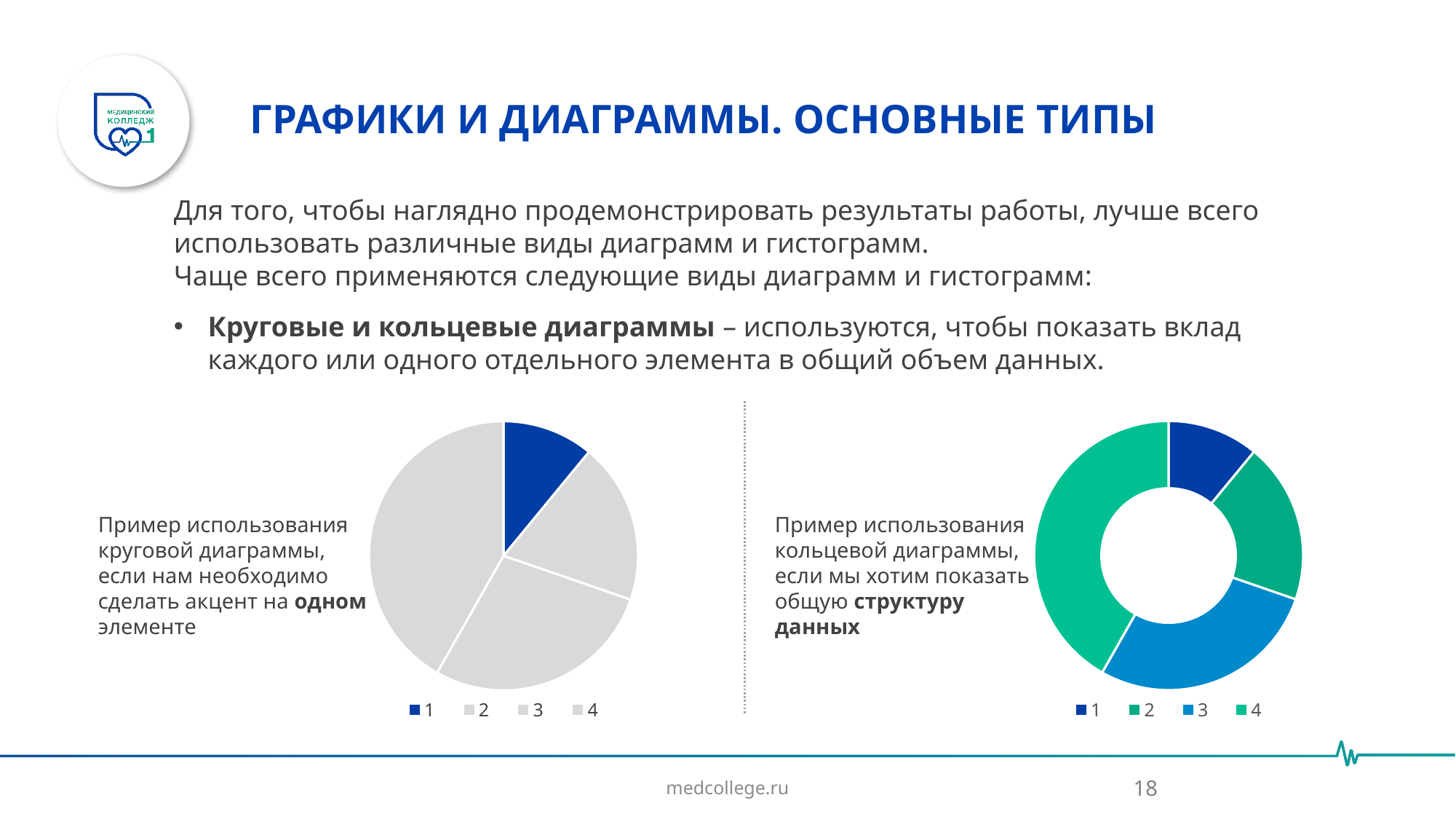
In the left pie chart, which slice is coloured blue while the others are grey? 1 What are the legend entries of the right doughnut chart? 1, 2, 3, 4 In the left pie chart, how many slices are there? 4 In the right doughnut chart, which segment is the smallest? 1 What kind of chart is the left chart on the slide? pie chart In the right doughnut chart, which is larger, segment 4 or segment 2? 4 In the left pie chart, which slice is the smallest? 1 In the left pie chart, which slice is the largest? 4 In the right doughnut chart, which segment is the largest? 4 How many entries does the legend of the left pie chart list? 4 What kind of chart is the right chart on the slide? doughnut chart In the right doughnut chart, how many segments are there? 4